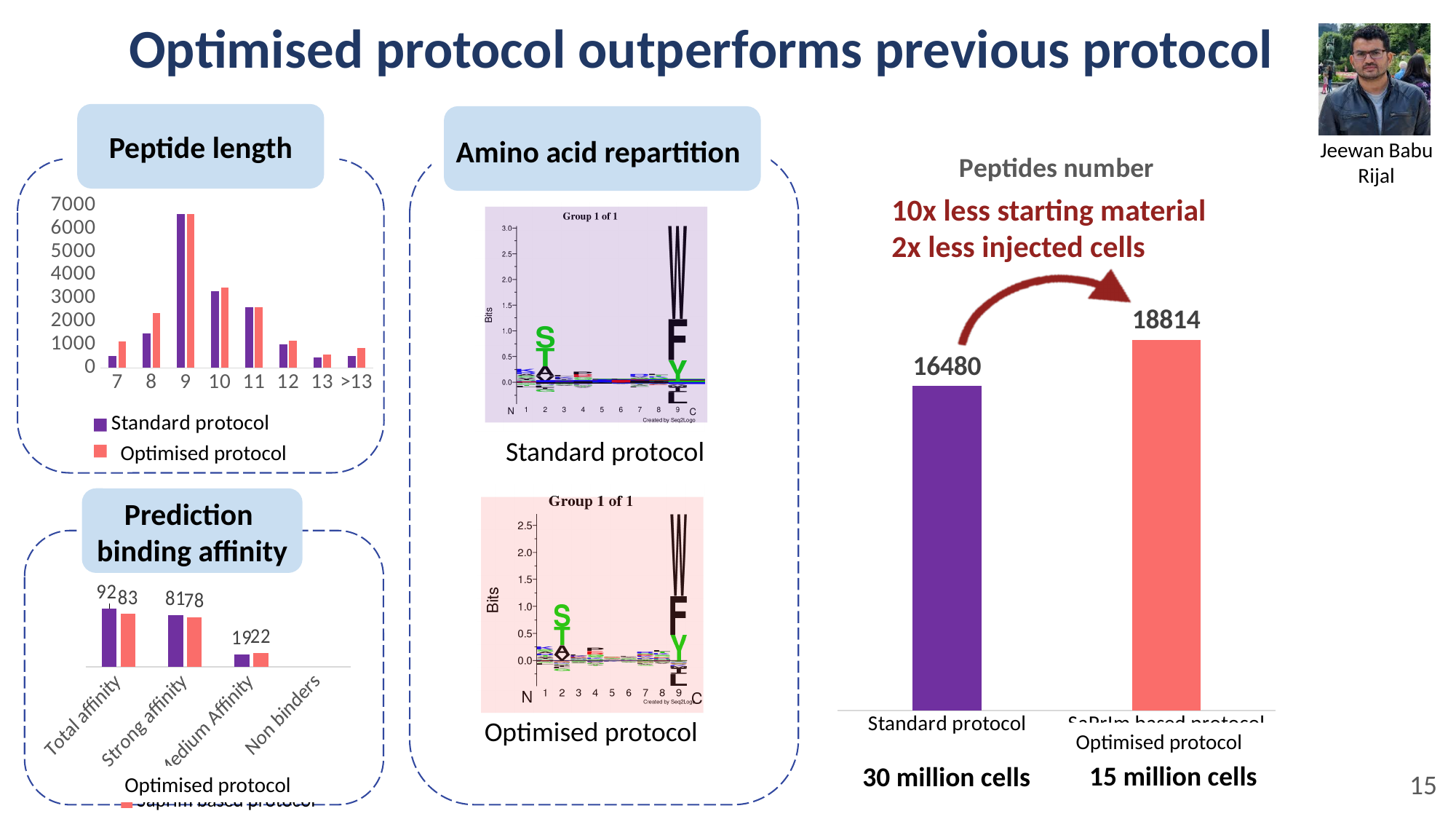
In the Peptide length chart, is the Standard protocol value for peptide length 7 greater or less than 1000? less In the Peptide length chart, which peptide length has the highest bars? 9 In the Prediction binding affinity chart, what is the value of the red bar for Medium Affinity? 22 What kind of chart is the Peptide length chart? bar chart In the Prediction binding affinity chart, what is the value of the purple bar for Total affinity? 92 In the Peptides number chart, what is the difference between the Optimised protocol and the Standard protocol values? 2334 How many peptide length categories are shown on the x axis of the Peptide length chart? 8 In the Peptide length chart, is the Optimised protocol value for peptide length 9 greater or less than 6000? greater In the Peptides number chart, which protocol has the higher value? Optimised protocol In the Peptides number chart, what is the value for the Standard protocol? 16480 In the Peptides number chart, what is the value for the Optimised protocol? 18814 How many series does the legend of the Peptide length chart list? 2